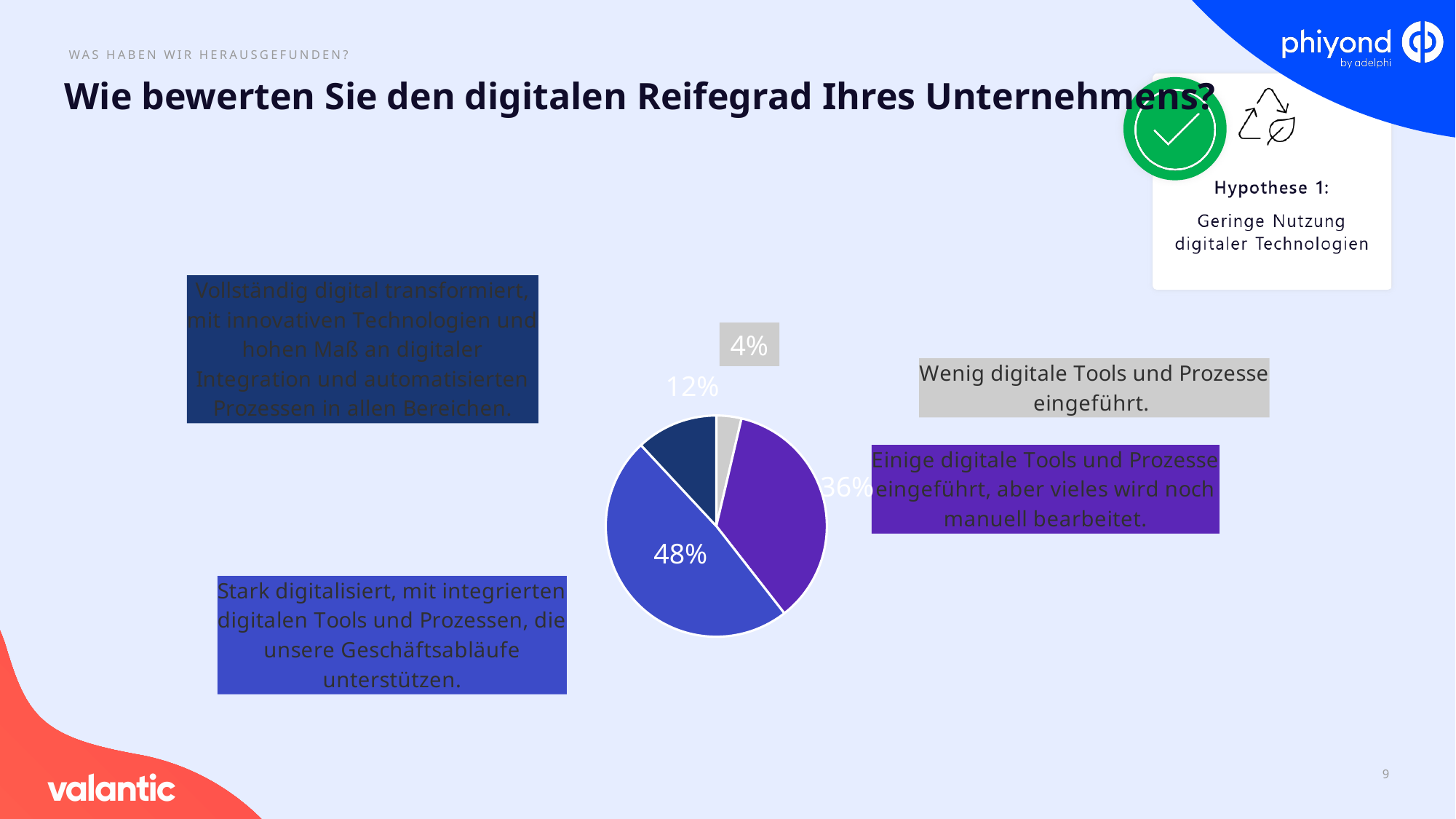
What share of the pie is labelled 'Vollständig digital transformiert'? 12% What is the difference in percentage points between the 48% slice and the 36% slice? 12 What kind of chart is shown on the slide? pie chart Which category has the largest slice of the pie? Stark digitalisiert, mit integrierten digitalen Tools und Prozessen What share of the pie is labelled 'Einige digitale Tools und Prozesse eingeführt, aber vieles wird noch manuell bearbeitet'? 36% Which category has the smallest slice of the pie? Wenig digitale Tools und Prozesse eingeführt What colour is the slice representing 'Wenig digitale Tools und Prozesse eingeführt'? grey What is the combined share of the 'Stark digitalisiert' and 'Vollständig digital transformiert' slices? 60% What share of the pie is labelled 'Stark digitalisiert, mit integrierten digitalen Tools und Prozessen'? 48% How many slices does the pie chart have? 4 Which is larger: the share for 'Vollständig digital transformiert' or the share for 'Wenig digitale Tools und Prozesse eingeführt'? Vollständig digital transformiert What share of the pie is labelled 'Wenig digitale Tools und Prozesse eingeführt'? 4%